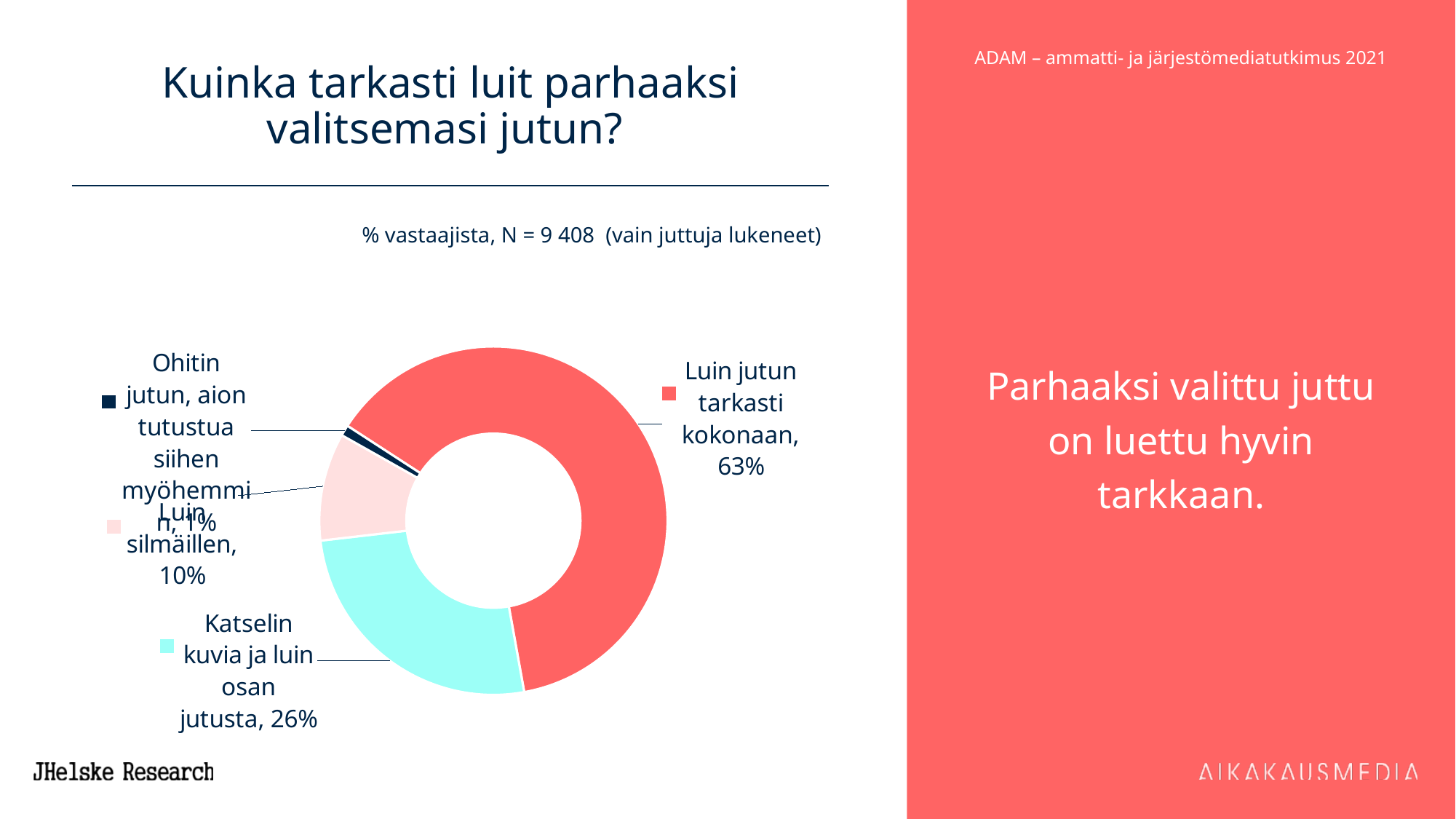
What is the difference in percentage points between "Luin jutun tarkasti kokonaan" and "Katselin kuvia ja luin osan jutusta"? 37 percentage points Which category has the smallest share of the chart? Ohitin jutun, aion tutustua siihen myöhemmin Which is larger: the share for "Luin silmäillen" or the share for "Katselin kuvia ja luin osan jutusta"? Katselin kuvia ja luin osan jutusta How many categories are shown in the chart? 4 What percentage of respondents chose "Ohitin jutun, aion tutustua siihen myöhemmin"? 1% What percentage of respondents chose "Luin silmäillen"? 10% What is the combined share of "Luin silmäillen" and "Ohitin jutun, aion tutustua siihen myöhemmin"? 11% What is the sample size (N) stated in the chart subtitle? 9 408 What kind of chart is shown on the slide? Donut (pie) chart What percentage of respondents chose "Luin jutun tarkasti kokonaan"? 63% Which category has the largest share of the chart? Luin jutun tarkasti kokonaan What percentage of respondents chose "Katselin kuvia ja luin osan jutusta"? 26%